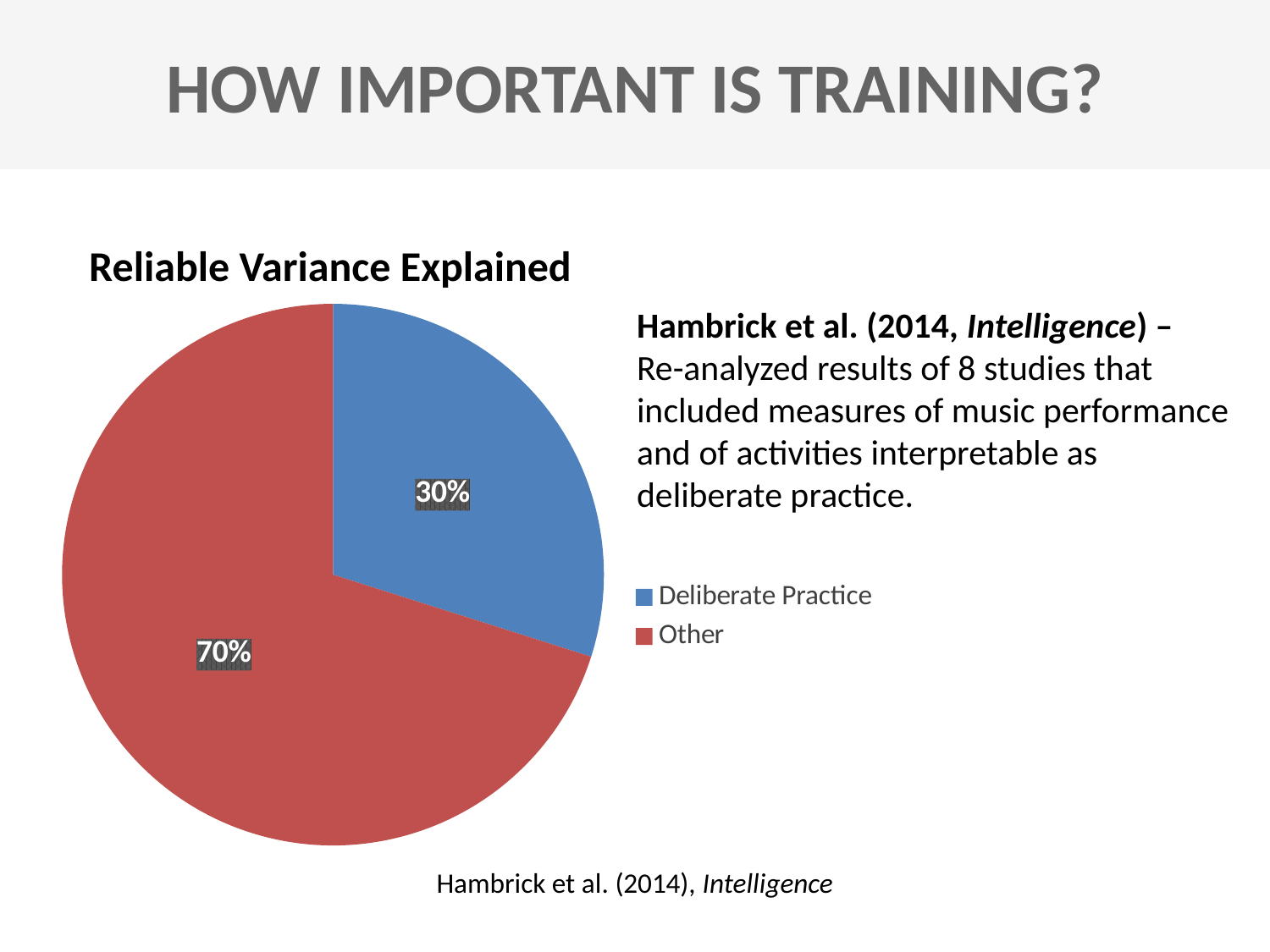
How many slices does the pie chart have? 2 What share of the pie is labelled Deliberate Practice? 30% Which slice of the pie is the smallest? Deliberate Practice What share of the pie is labelled Other? 70% Which slice of the pie is the largest? Other What kind of chart is shown on the slide? pie chart What colour is the Deliberate Practice slice? blue Which is larger, the Deliberate Practice slice or the Other slice? Other How many entries does the legend list? 2 What is the difference in percentage points between the Other slice and the Deliberate Practice slice? 40 What is the title of the chart? Reliable Variance Explained